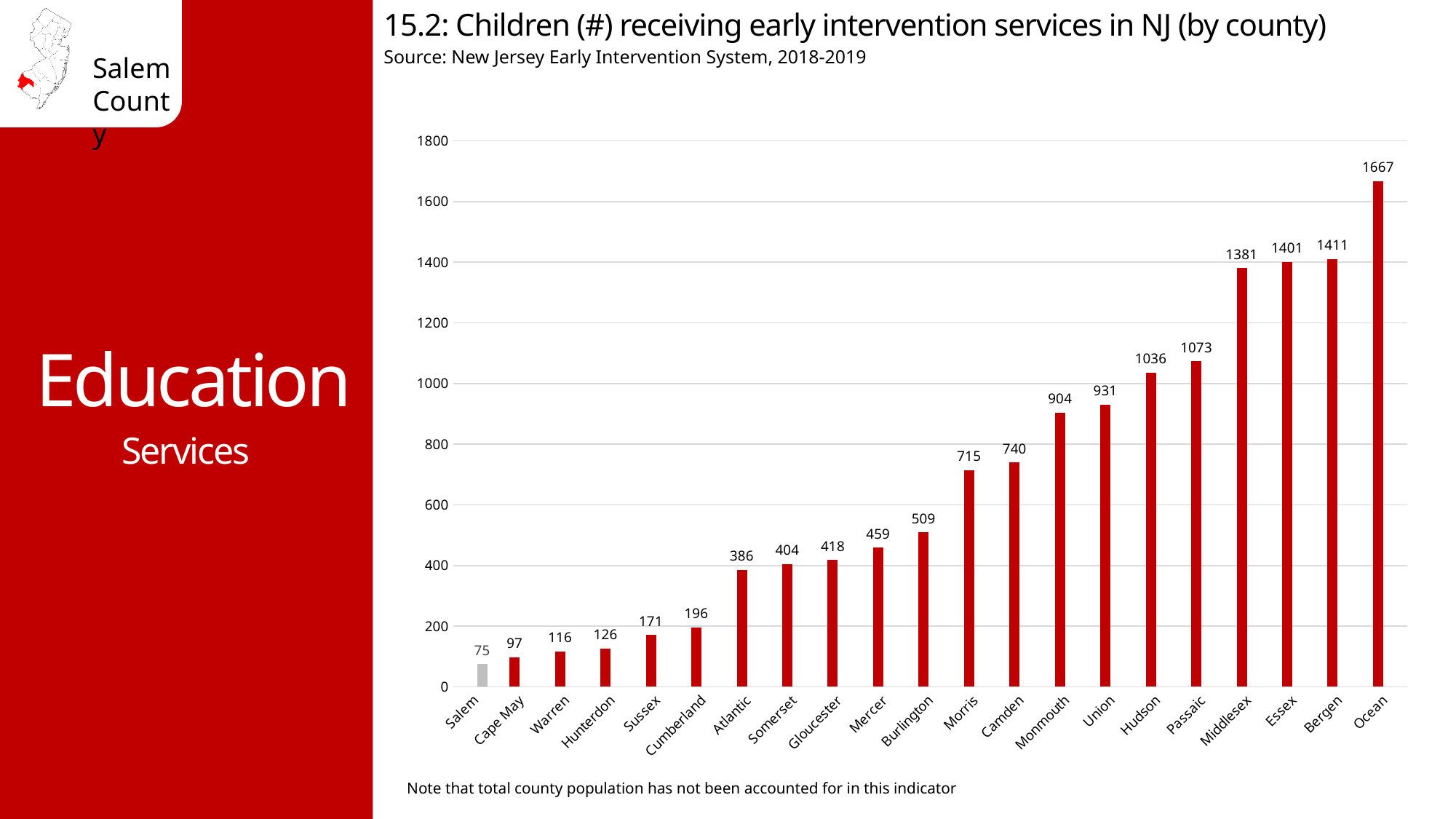
Which county has the highest number of children receiving early intervention services? Ocean Which county has a larger value, Morris or Camden? Camden Is the value for Hudson greater or less than 1000? greater What kind of chart is shown on the slide? Bar chart How many counties are shown on the chart? 21 What is the difference between the values for Bergen and Essex? 10 Which county's bar is coloured grey instead of red? Salem How many children received early intervention services in Salem County? 75 What is the value shown for Middlesex County? 1381 What is the value shown for Ocean County? 1667 Which county has the lowest number of children receiving early intervention services? Salem What is the difference between the values for Ocean and Salem? 1592